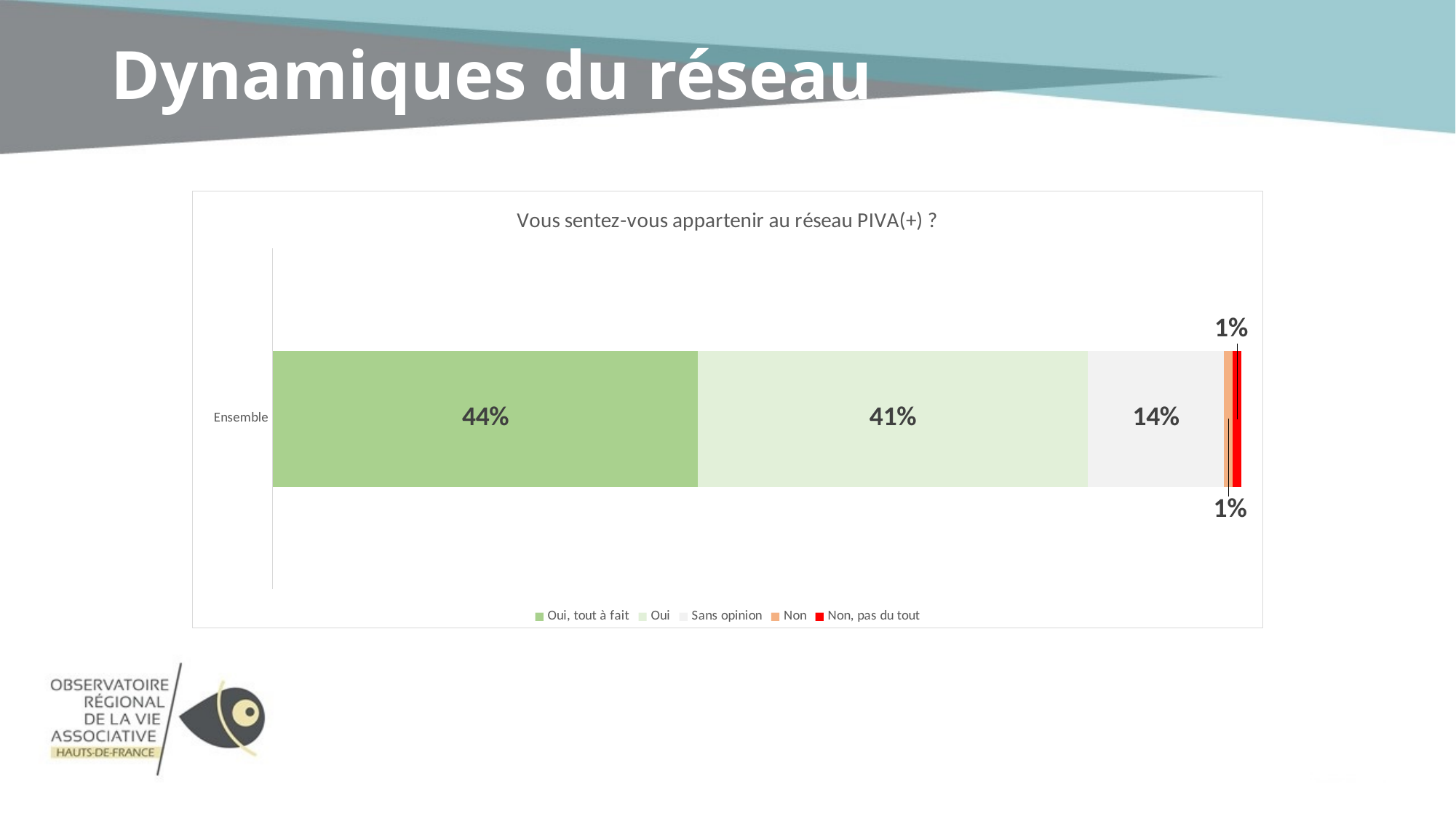
What is the title of the chart? Vous sentez-vous appartenir au réseau PIVA(+) ? How many series does the legend list? 5 Which is larger, the value for "Oui, tout à fait" or the value for "Sans opinion"? Oui, tout à fait What is the value for "Oui, tout à fait" in the Ensemble bar? 44% Which response has the highest share in the Ensemble bar? Oui, tout à fait What is the value for "Non" in the Ensemble bar? 1% What kind of chart is shown on the slide? Stacked bar chart What is the value for "Sans opinion" in the Ensemble bar? 14% How many categories are plotted on the y axis? 1 What is the difference between the "Oui" and "Sans opinion" values? 27% What is the value for "Oui" in the Ensemble bar? 41% What is the difference between the "Oui, tout à fait" and "Oui" values? 3%